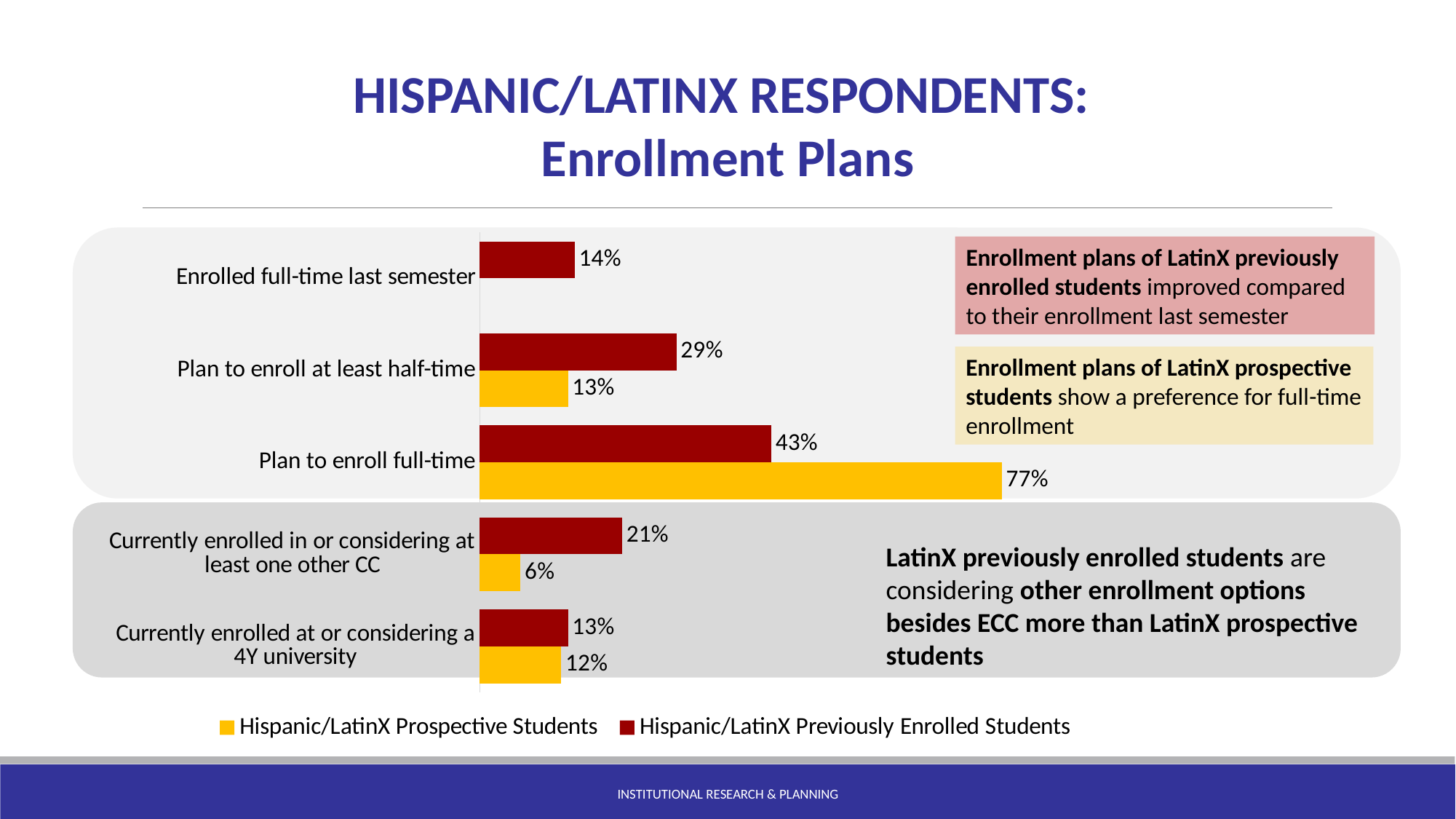
How many categories are shown on the chart? 5 Which category has the lowest value for Hispanic/LatinX Prospective Students? Currently enrolled in or considering at least one other CC Which colour represents Hispanic/LatinX Prospective Students in the chart? Yellow How many series does the legend list? 2 Which category has the highest value for Hispanic/LatinX Previously Enrolled Students? Plan to enroll full-time What percentage of Hispanic/LatinX Prospective Students plan to enroll full-time? 77% What is the difference between Prospective Students and Previously Enrolled Students for 'Plan to enroll full-time'? 34% For 'Plan to enroll at least half-time', which group has the larger value: Prospective Students or Previously Enrolled Students? Hispanic/LatinX Previously Enrolled Students What percentage of Hispanic/LatinX Previously Enrolled Students were enrolled full-time last semester? 14% What type of chart is shown on the slide? Bar chart What percentage of Hispanic/LatinX Prospective Students are currently enrolled in or considering at least one other CC? 6% What percentage of Hispanic/LatinX Previously Enrolled Students plan to enroll full-time? 43%